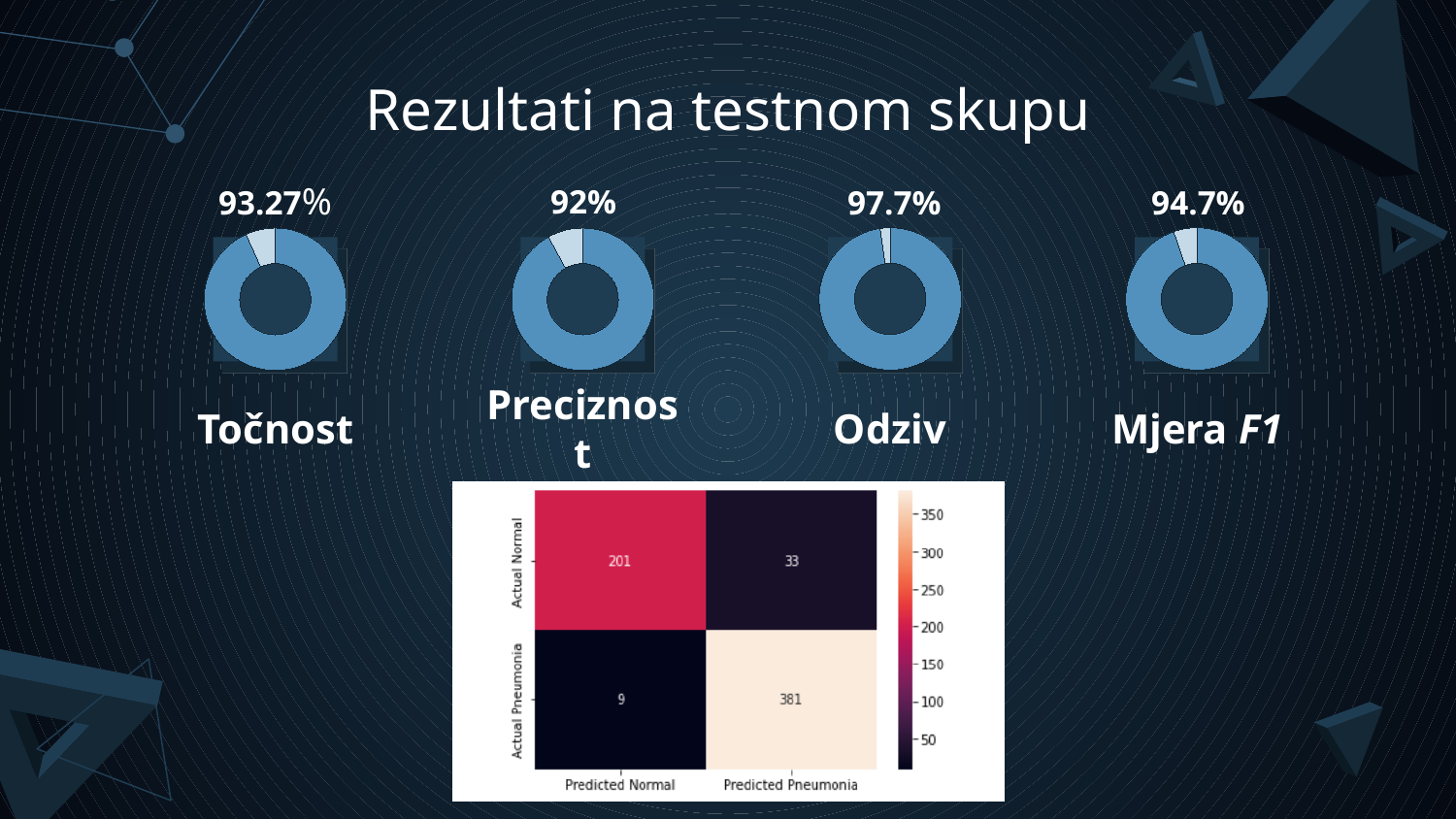
Among the four donut charts (Točnost, Preciznost, Odziv, Mjera F1), which metric has the lowest value? Preciznost On the Mjera F1 donut chart, what value is shown? 94.7% In the confusion matrix at the bottom of the slide, what is the value for Actual Pneumonia and Predicted Normal? 9 In the confusion matrix at the bottom of the slide, what is the value for Actual Normal and Predicted Normal? 201 In the confusion matrix at the bottom of the slide, what is the value for Actual Normal and Predicted Pneumonia? 33 In the confusion matrix at the bottom of the slide, which cell has the highest value? Actual Pneumonia / Predicted Pneumonia (381) In the confusion matrix at the bottom of the slide, what is the difference between the Actual Pneumonia / Predicted Pneumonia value and the Actual Normal / Predicted Normal value? 180 On the Preciznost donut chart, what value is shown? 92% On the Odziv donut chart, what value is shown? 97.7% On the Točnost donut chart, what value is shown? 93.27% Among the four donut charts (Točnost, Preciznost, Odziv, Mjera F1), which metric has the highest value? Odziv What kind of chart is used for the four metrics at the top of the slide? Donut (pie) chart